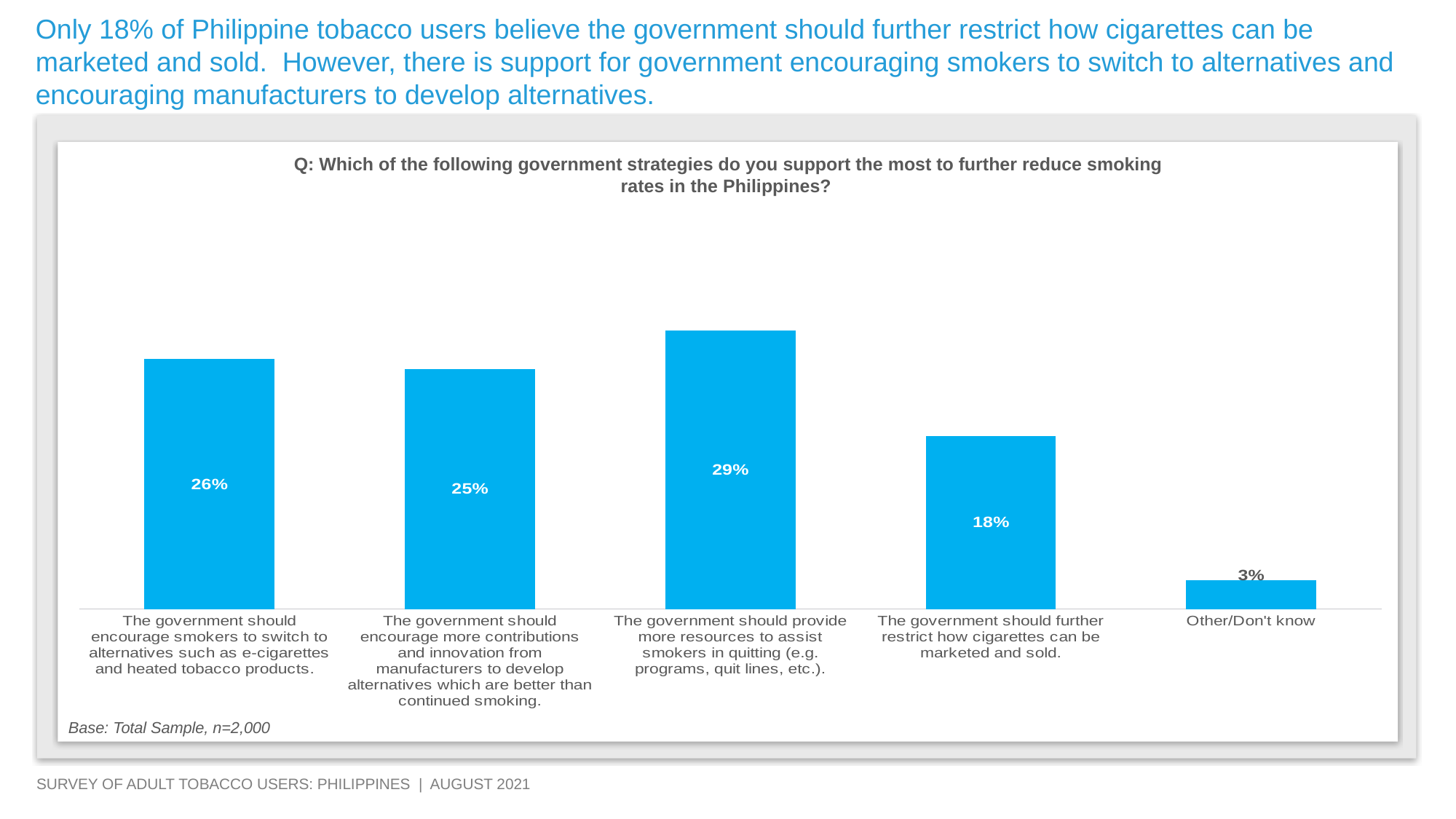
How many categories are shown in the chart? 5 What type of chart is shown on the slide? Bar chart What percentage of respondents support the government encouraging smokers to switch to alternatives such as e-cigarettes and heated tobacco products? 26% Which has a larger share: encouraging smokers to switch to alternatives, or encouraging more contributions and innovation from manufacturers? Encouraging smokers to switch to alternatives Which government strategy received the highest level of support? The government should provide more resources to assist smokers in quitting (e.g. programs, quit lines, etc.). What percentage of respondents support the government providing more resources to assist smokers in quitting? 29% What is the combined share of the two strategies about encouraging alternatives (switching smokers and manufacturer innovation)? 51% Which category has the lowest value in the chart? Other/Don't know What percentage of respondents support the government further restricting how cigarettes can be marketed and sold? 18% What is the base sample size noted on the chart? Total Sample, n=2,000 What is the difference between the share supporting more resources to assist smokers in quitting and the share supporting further restrictions on cigarette marketing and sales? 11% What percentage of respondents answered Other/Don't know? 3%